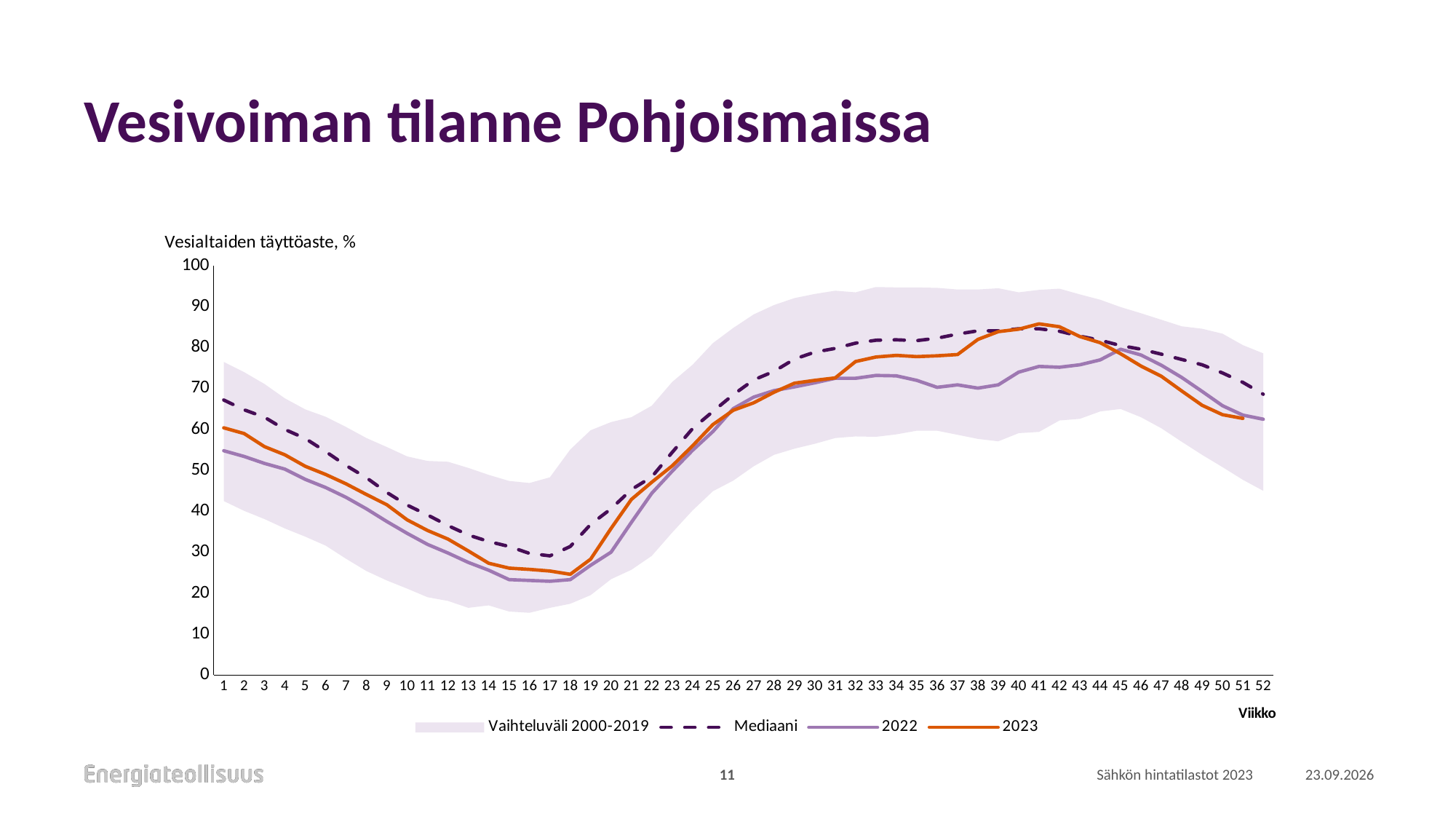
How many weeks are shown along the x axis of the chart? 52 Is the value of the 2022 line at week 15 greater or less than 30? less Is the value of the Mediaani line at week 1 greater or less than 60? greater Is the value of the 2023 line at week 41 greater or less than 80? greater What kind of chart is shown on the slide? line chart What is the label of the chart's y axis? Vesialtaiden täyttöaste, % How many entries does the chart legend list? 4 At week 41, which line is higher: 2022 or 2023? 2023 What is the title of the slide containing the chart? Vesivoiman tilanne Pohjoismaissa At week 36, which line is higher: Mediaani or 2022? Mediaani Does the 2023 line rise or fall from week 1 to week 15? fall